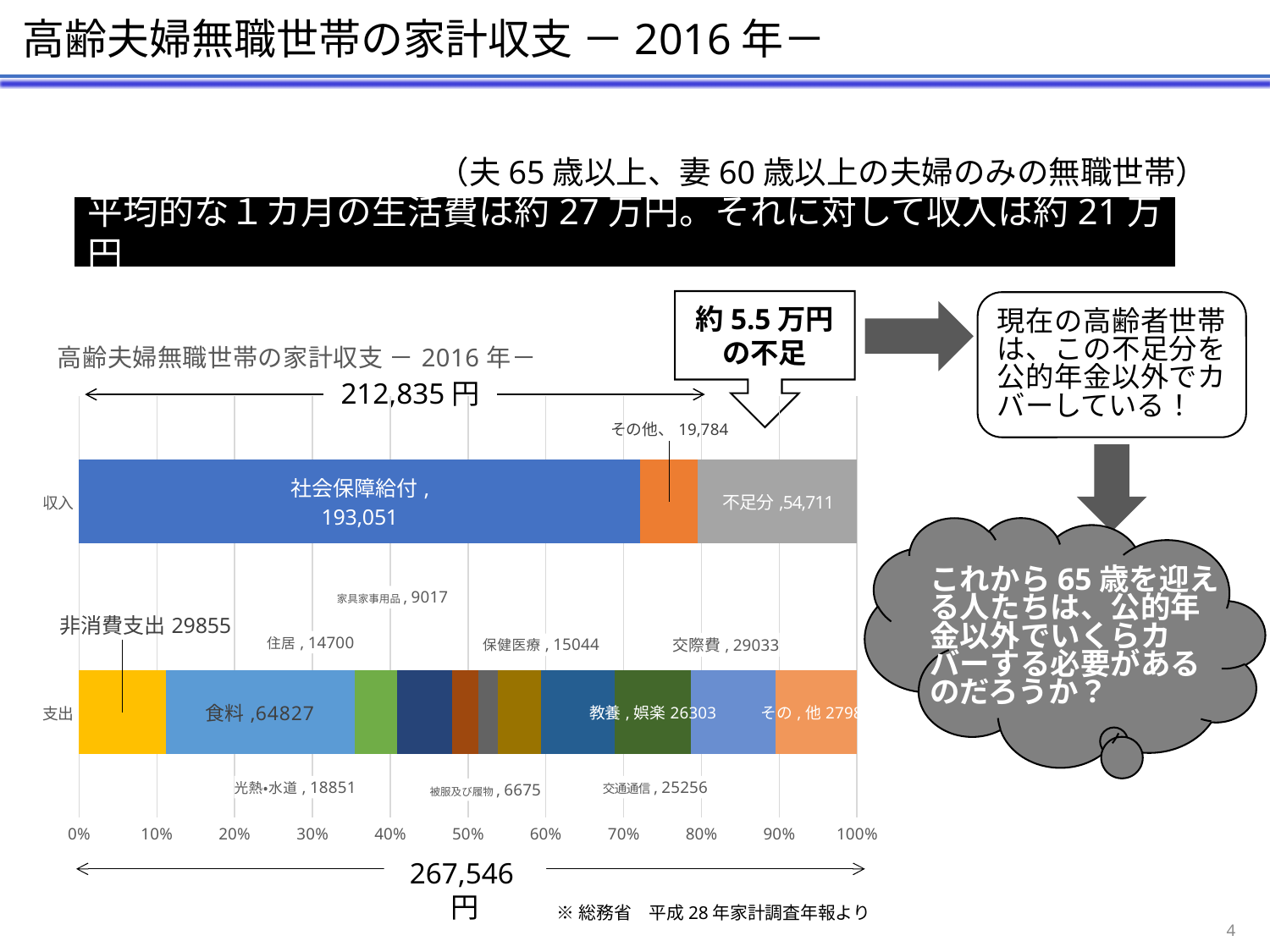
What is the value of 不足分 in the 収入 bar? 54,711 What is the difference between 社会保障給付 and その他 in the 収入 bar? 173,267 What is the value of 社会保障給付 in the 収入 bar? 193,051 What is the value of 食料 in the 支出 bar? 64827 How many bars (categories) does the chart show? 2 Which is larger in the 支出 bar, 交際費 or 教養娯楽? 交際費 What is the title of the chart? 高齢夫婦無職世帯の家計収支 － 2016 年－ Which labelled item in the 支出 bar has the largest value? 食料 Which labelled item in the 支出 bar has the smallest value? 被服及び履物 What kind of chart is shown on the slide? bar chart What is the total shown for the 収入 bar? 212,835円 What is the value of 交通通信 in the 支出 bar? 25256